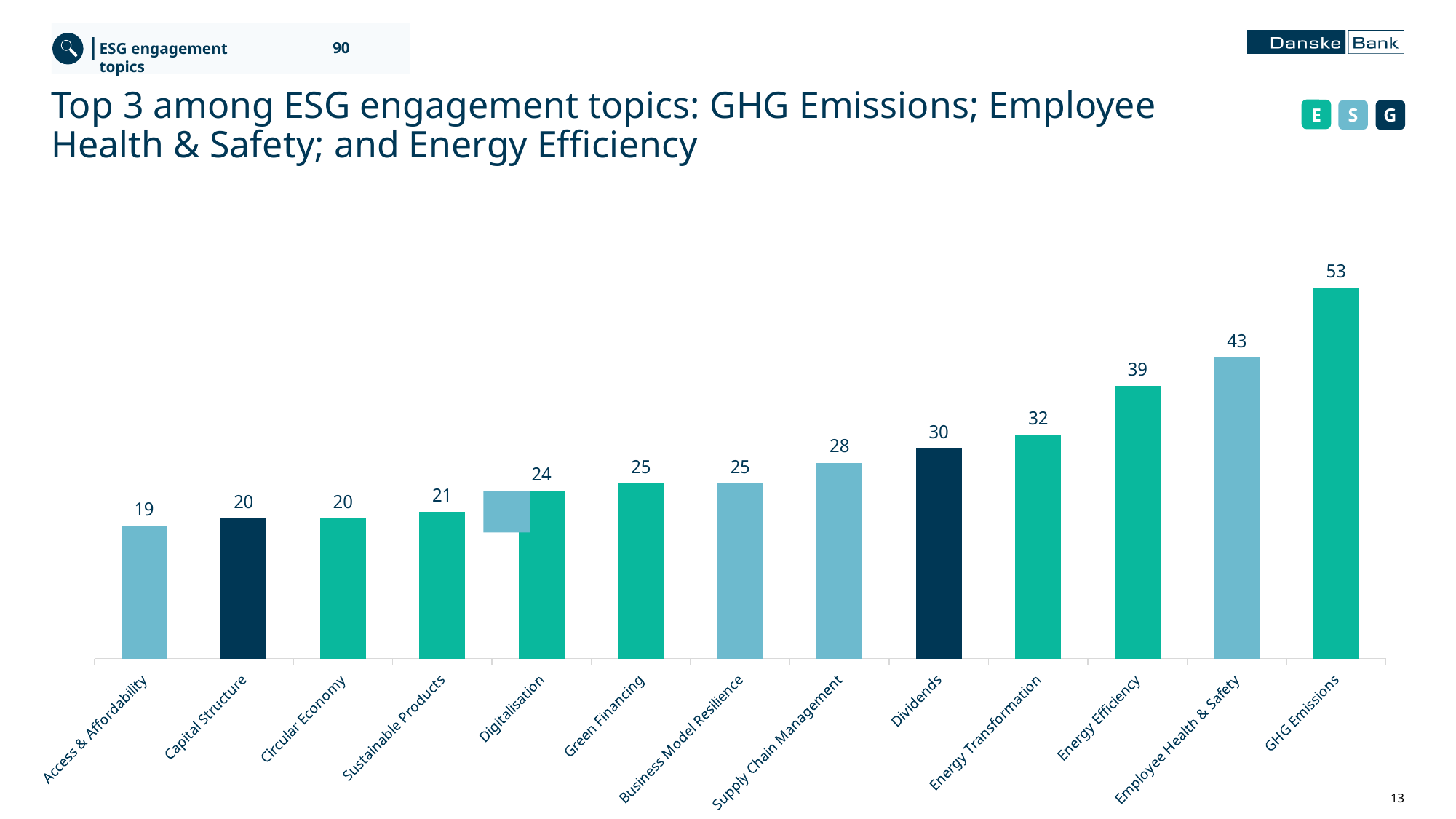
What is the difference between the values for Dividends and Sustainable Products? 9 Which category has the lowest value? Access & Affordability Which is larger, the value for Energy Transformation or the value for Supply Chain Management? Energy Transformation What kind of chart is shown on the slide? Bar chart What is the value for Supply Chain Management? 28 How many categories are shown on the x axis? 13 What is the value for GHG Emissions? 53 What is the value for Digitalisation? 24 What is the difference between the values for GHG Emissions and Energy Efficiency? 14 What is the value for Employee Health & Safety? 43 Which category has the highest value? GHG Emissions Do the values rise or fall from left to right along the x axis? Rise